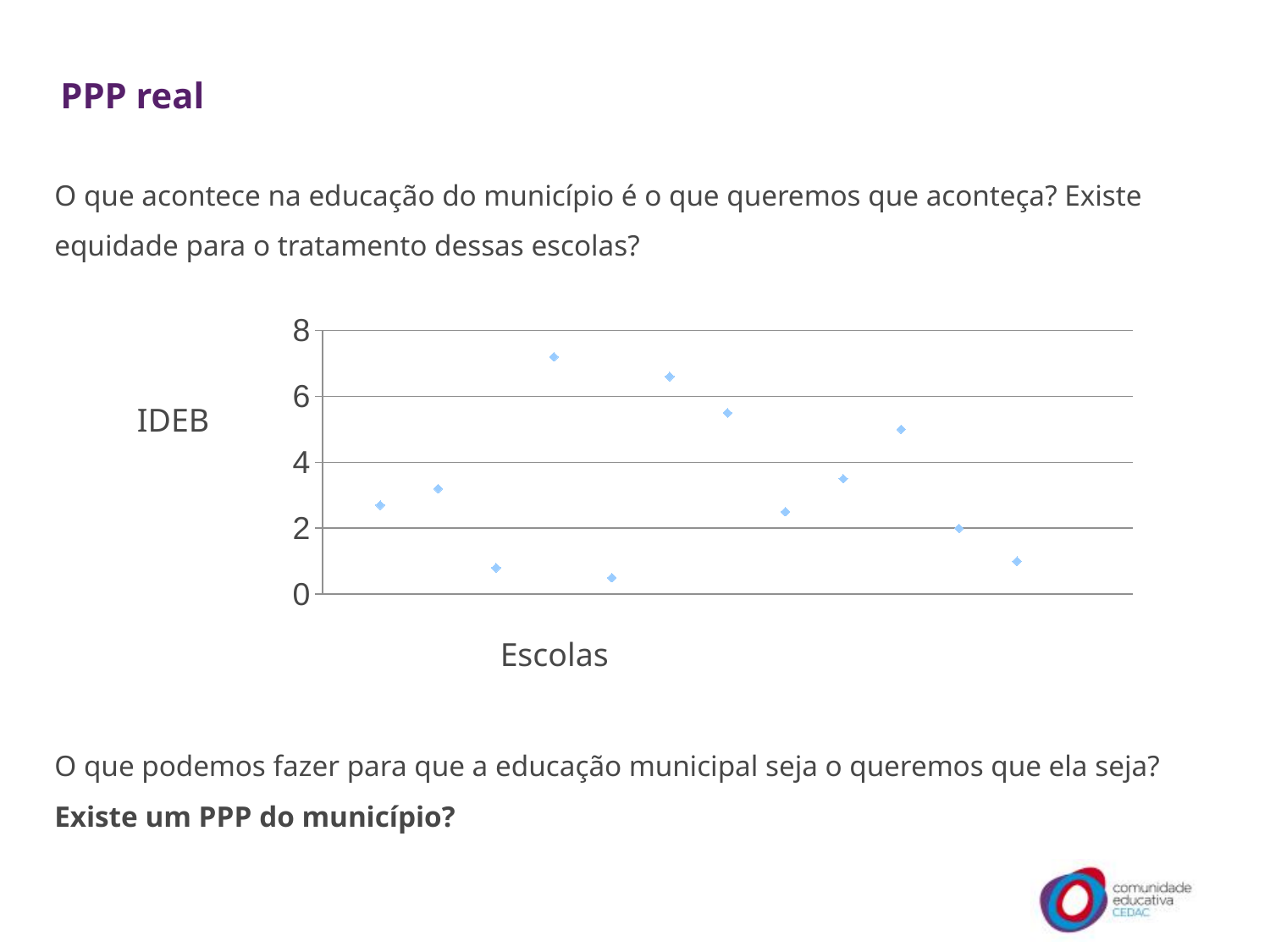
Is the last (rightmost) plotted point in the chart greater or less than 2? less Is the first (leftmost) plotted point in the chart greater or less than 4? less How many data points are plotted in the chart? 12 How many plotted points in the chart lie above the 4 gridline? 4 What is the label of the horizontal axis of the chart? Escolas What is the highest value shown on the vertical axis of the chart? 8 Is the highest plotted point in the chart greater or less than 6? greater Does the chart show a steady rising or falling trend from left to right, or no clear trend? No clear trend What kind of chart is shown on the slide? Scatter chart How many plotted points in the chart lie above the 6 gridline? 2 What is the label of the vertical axis of the chart? IDEB